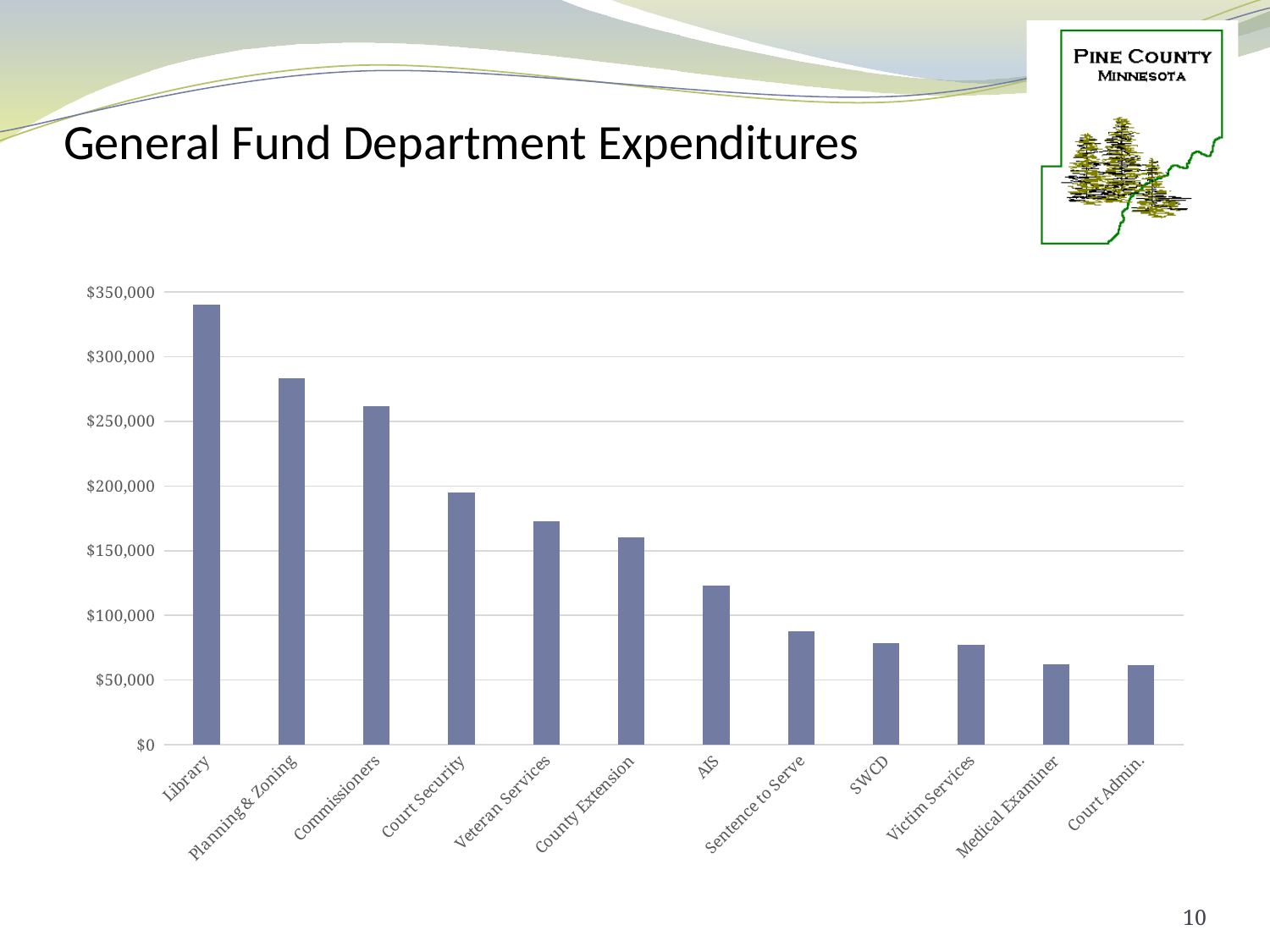
Is the value for Library greater or less than $300,000? greater What is the title of the chart? General Fund Department Expenditures Is the value for Commissioners greater or less than $250,000? greater Is the value for AIS greater or less than $100,000? greater Do the expenditures rise or fall moving from left to right across the chart? Fall Which is larger, the expenditure for Court Security or for County Extension? Court Security How many departments are shown on the chart? 12 Which department has the highest expenditure? Library What kind of chart is shown on the slide? Bar chart Which is larger, the expenditure for Planning & Zoning or for Commissioners? Planning & Zoning